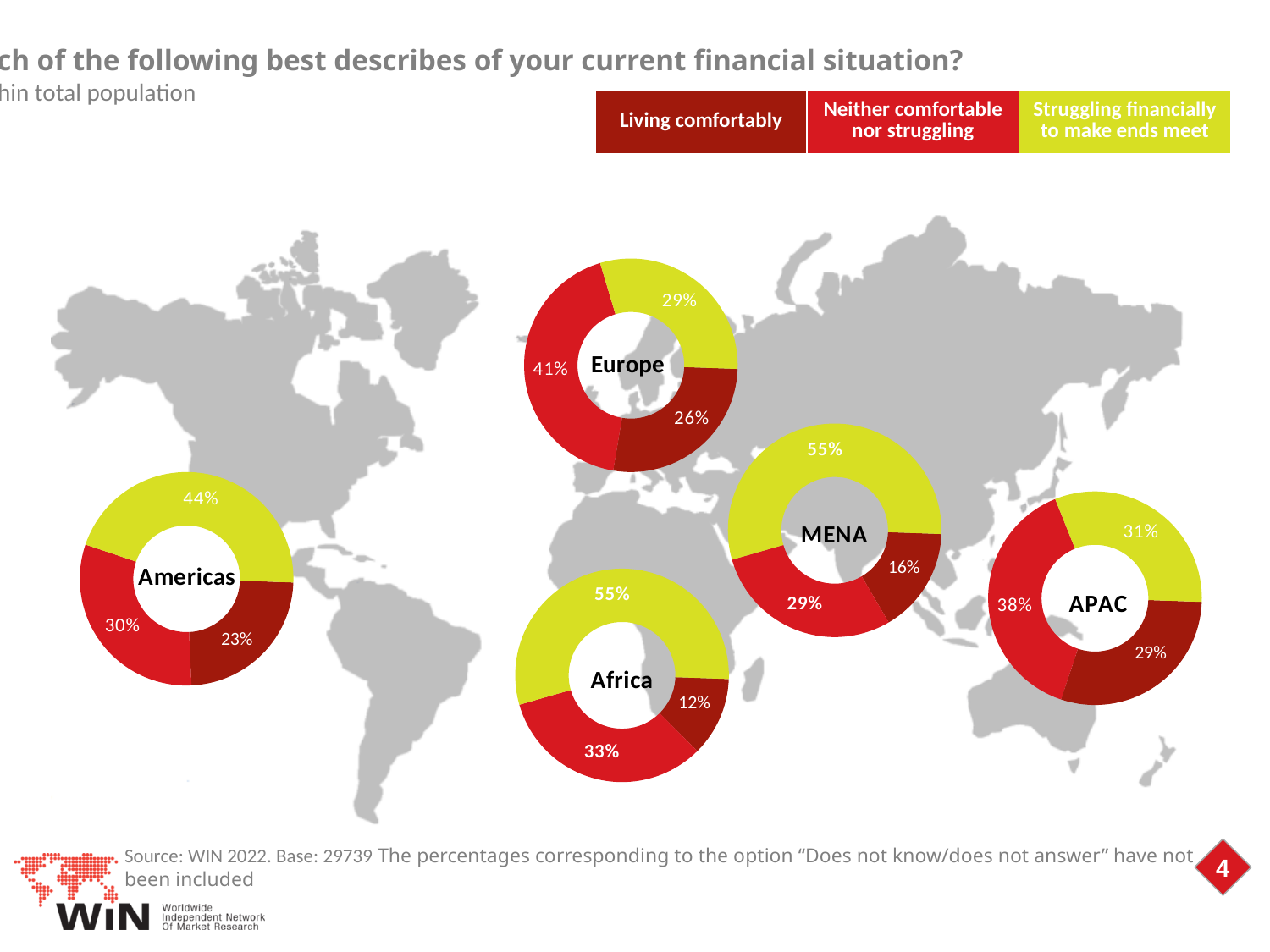
In the Europe chart, which category has the smallest share? Living comfortably In the APAC chart, what percentage is shown for 'Neither comfortable nor struggling'? 38% Which colour represents 'Struggling financially to make ends meet' in the legend? Yellow-green How many categories does the legend list? 3 How many regional charts are shown on the slide? 5 In the Africa chart, what percentage is shown for 'Living comfortably'? 12% In the Europe chart, what percentage is shown for 'Neither comfortable nor struggling'? 41% In the Americas chart, what percentage is shown for 'Struggling financially to make ends meet'? 44% In the MENA chart, which category has the largest share? Struggling financially to make ends meet What kind of chart is used for each region on the slide? Donut (pie) chart Which region shows a higher 'Living comfortably' percentage, APAC or MENA? APAC In the Africa chart, what is the difference between the 'Struggling financially to make ends meet' share and the 'Living comfortably' share? 43 percentage points